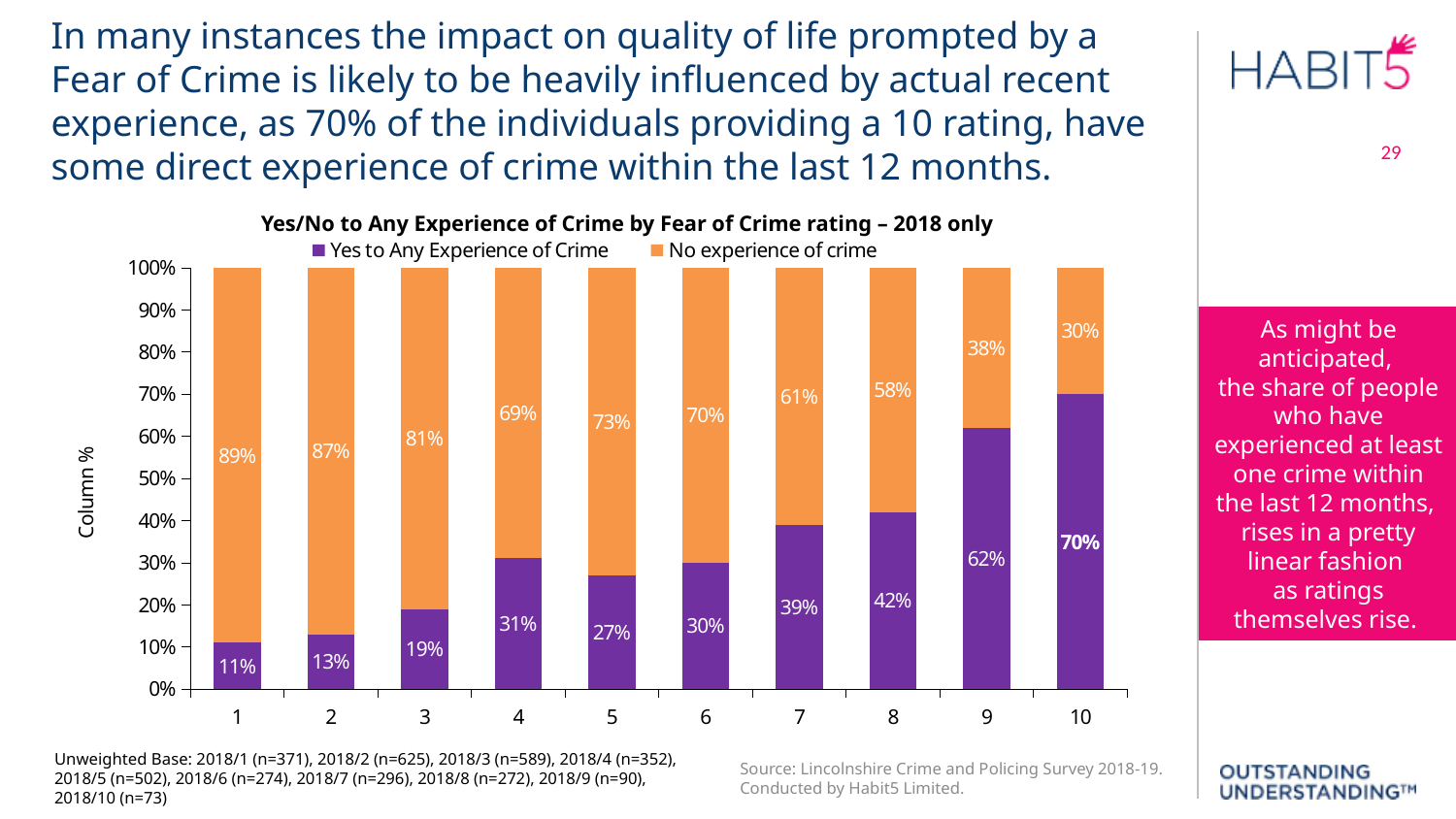
Does the share of "Yes to Any Experience of Crime" generally rise or fall as the Fear of Crime rating increases from 1 to 10? Rise How many series does the legend list? 2 What is the difference between the "Yes to Any Experience of Crime" values for rating 9 and rating 8? 20% Which Fear of Crime rating has the highest share of "Yes to Any Experience of Crime"? 10 How many Fear of Crime rating categories are shown on the x axis? 10 What is the value for "Yes to Any Experience of Crime" at Fear of Crime rating 7? 39% Which has a larger "Yes to Any Experience of Crime" value, rating 4 or rating 5? Rating 4 What is the value for "No experience of crime" at Fear of Crime rating 1? 89% Which Fear of Crime rating has the lowest share of "Yes to Any Experience of Crime"? 1 What is the total of the stacked bar for Fear of Crime rating 5? 100% What kind of chart is shown on the slide? Stacked bar chart What is the value for "Yes to Any Experience of Crime" at Fear of Crime rating 10? 70%